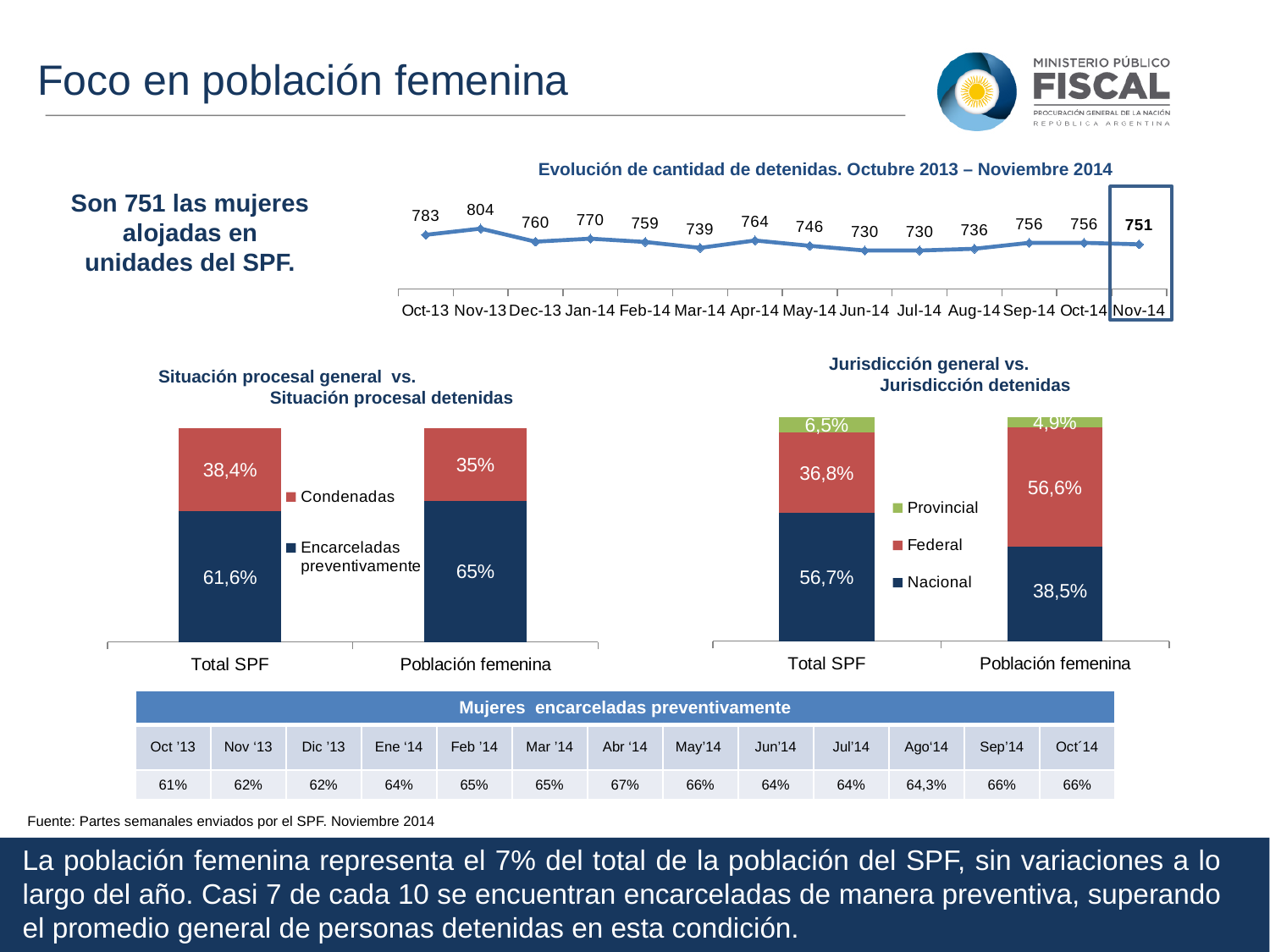
In the chart 'Jurisdicción general vs. Jurisdicción detenidas', how many series does the legend list? 3 In the chart 'Evolución de cantidad de detenidas. Octubre 2013 – Noviembre 2014', how many months are plotted? 14 In the chart 'Situación procesal general vs. Situación procesal detenidas', what is the value of 'Condenadas' for Total SPF? 38,4% In the chart 'Evolución de cantidad de detenidas. Octubre 2013 – Noviembre 2014', what is the difference between the values for Oct-13 and Nov-13? 21 What kind of chart is 'Evolución de cantidad de detenidas. Octubre 2013 – Noviembre 2014'? Line chart In the chart 'Evolución de cantidad de detenidas. Octubre 2013 – Noviembre 2014', which month has the highest value? Nov-13 In the chart 'Situación procesal general vs. Situación procesal detenidas', what is the value of 'Encarceladas preventivamente' for Población femenina? 65% In the chart 'Evolución de cantidad de detenidas. Octubre 2013 – Noviembre 2014', what is the lowest value shown? 730 In the chart 'Evolución de cantidad de detenidas. Octubre 2013 – Noviembre 2014', what is the value for Nov-14? 751 In the chart 'Jurisdicción general vs. Jurisdicción detenidas', what is the value of 'Federal' for Población femenina? 56,6% In the chart 'Jurisdicción general vs. Jurisdicción detenidas', what is the difference between the 'Nacional' values for Total SPF and Población femenina? 18,2% In the chart 'Situación procesal general vs. Situación procesal detenidas', which is larger: 'Encarceladas preventivamente' for Total SPF or for Población femenina? Población femenina